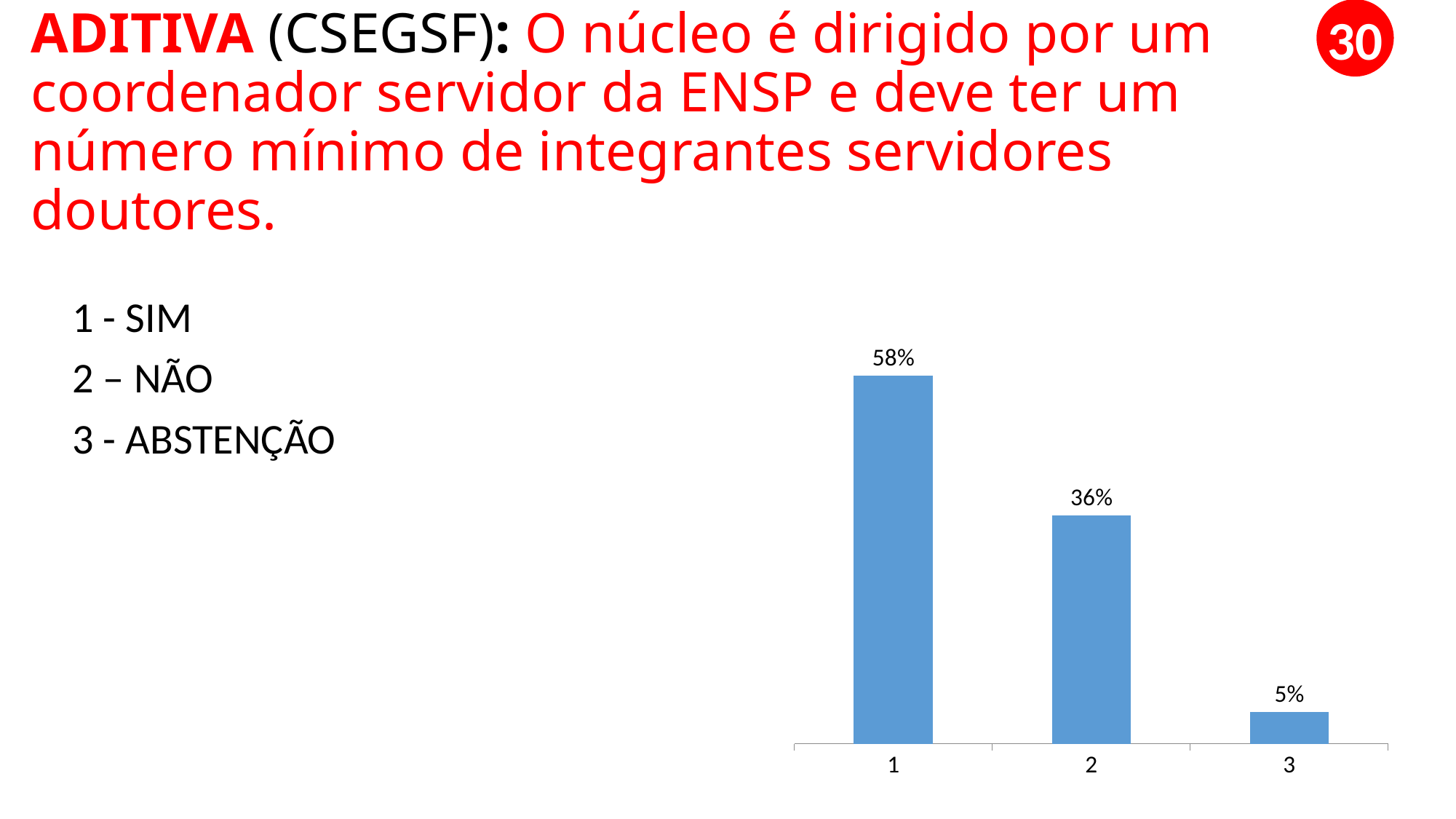
What is the difference between the values for category 2 and category 3? 31% What is the difference between the values for category 1 and category 2? 22% Do the values rise or fall from category 1 to category 3? fall According to the slide's key, what does category 3 in the chart stand for? ABSTENÇÃO Which category has the highest value in the chart? 1 What is the value for category 1 in the chart? 58% What is the value for category 3 in the chart? 5% What kind of chart is shown on the slide? bar chart Which category has the lowest value in the chart? 3 What is the value for category 2 in the chart? 36% How many categories are shown on the x axis of the chart? 3 Which is larger, the value for category 1 or the value for category 2? 1